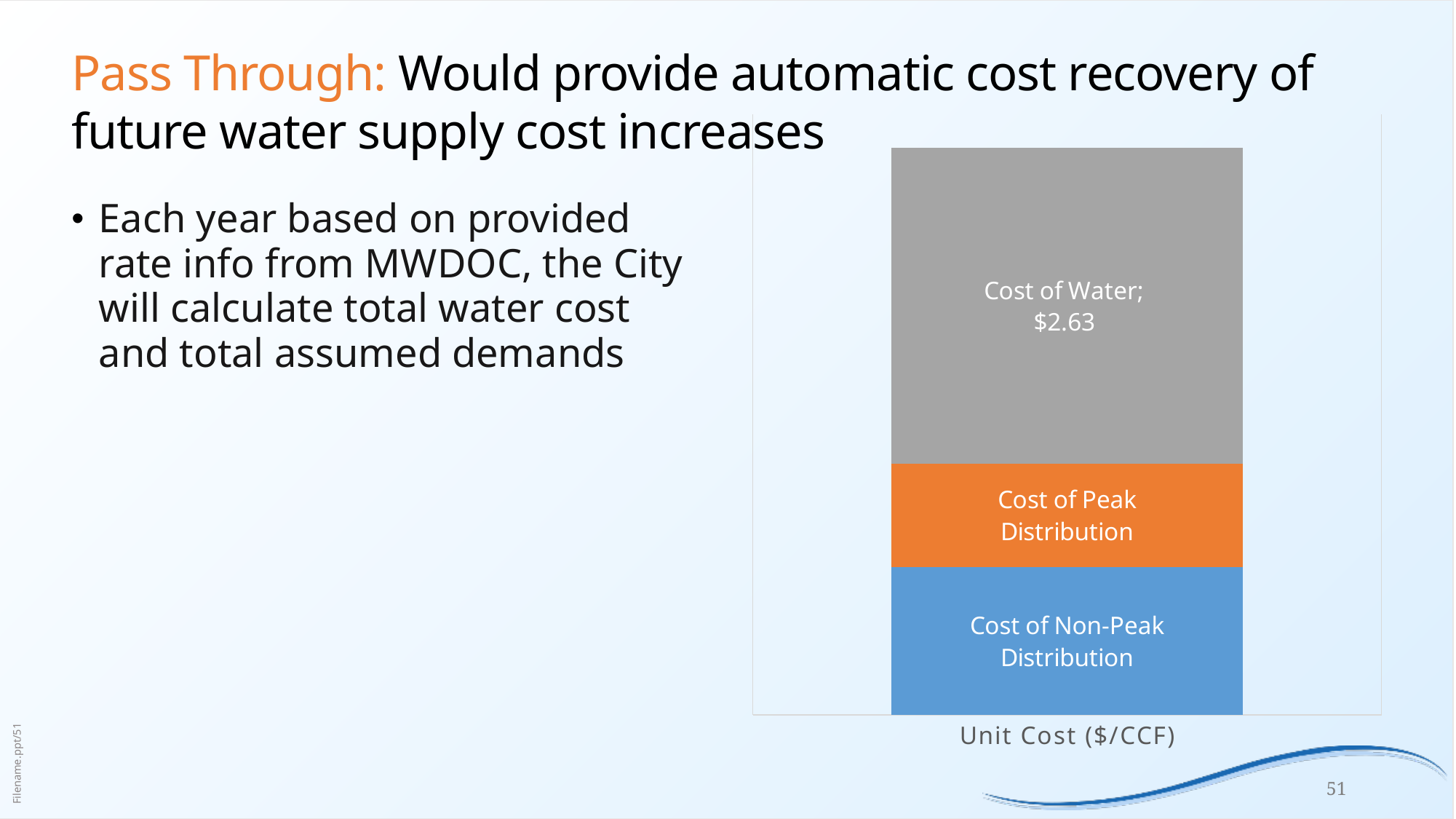
Which segment is at the bottom of the stacked bar? Cost of Non-Peak Distribution Which segment of the bar is the smallest? Cost of Peak Distribution Which is larger, the Cost of Water segment or the Cost of Peak Distribution segment? Cost of Water How many bars are plotted in the chart? 1 What kind of chart is shown on the slide? Stacked bar chart What is the value shown for the Cost of Water segment? $2.63 What colour is the Cost of Water segment? Grey Which is larger, the Cost of Non-Peak Distribution segment or the Cost of Peak Distribution segment? Cost of Non-Peak Distribution Which segment of the bar is the largest? Cost of Water How many segments make up the stacked bar? 3 What is the label on the horizontal axis of the chart? Unit Cost ($/CCF)